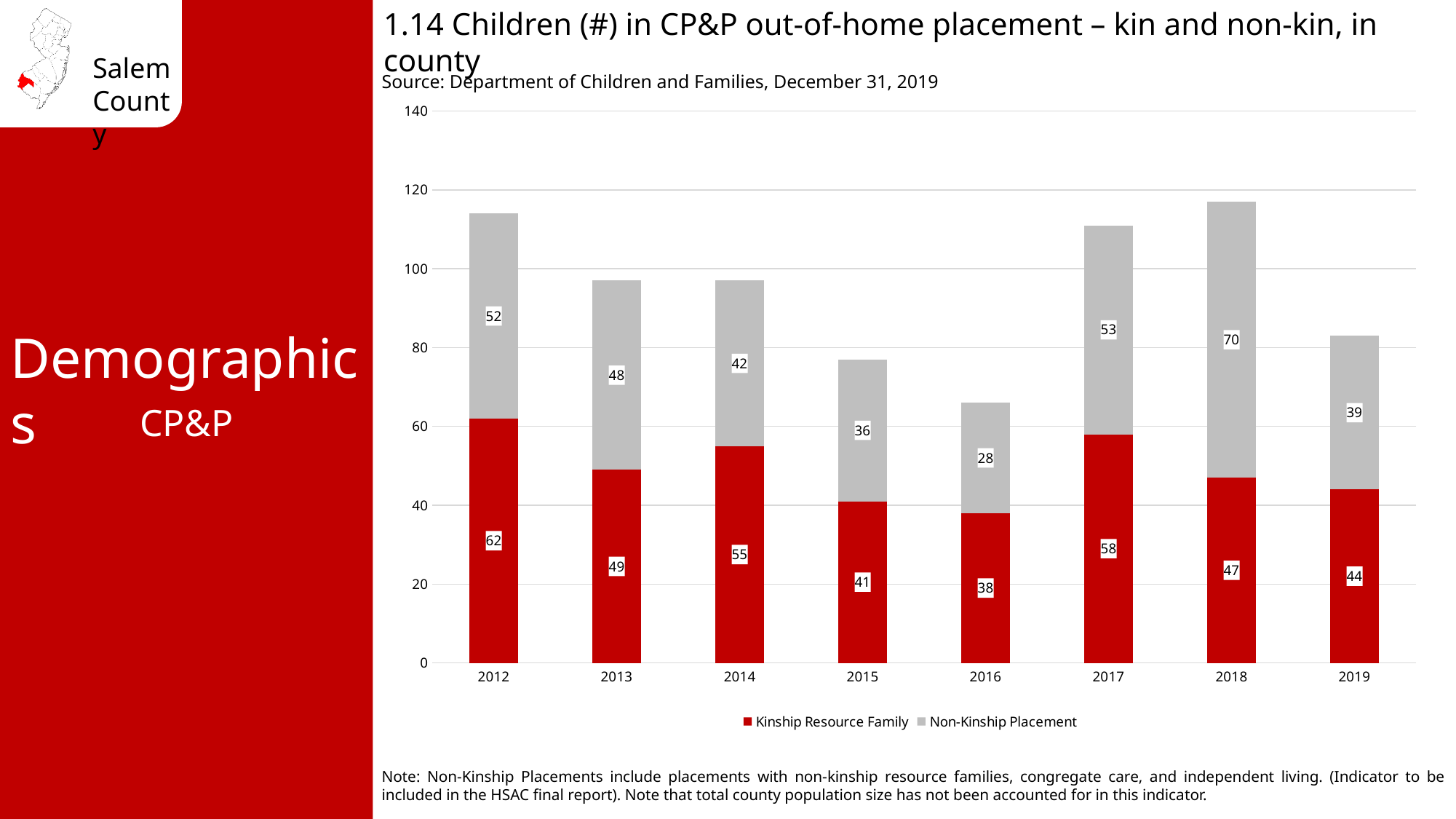
How many years are shown on the x axis? 8 How many series does the legend list? 2 What is the total number of children in out-of-home placement in 2017? 111 What is the Kinship Resource Family value for 2012? 62 What is the difference between the Kinship Resource Family values for 2012 and 2013? 13 Which year has the highest Non-Kinship Placement value? 2018 Which year has the lowest Kinship Resource Family value? 2016 Which is larger, the Non-Kinship Placement value for 2015 or for 2016? 2015 What kind of chart is shown? Stacked bar chart What is the Kinship Resource Family value for 2019? 44 What is the total number of children in out-of-home placement in 2016? 66 What is the Non-Kinship Placement value for 2018? 70